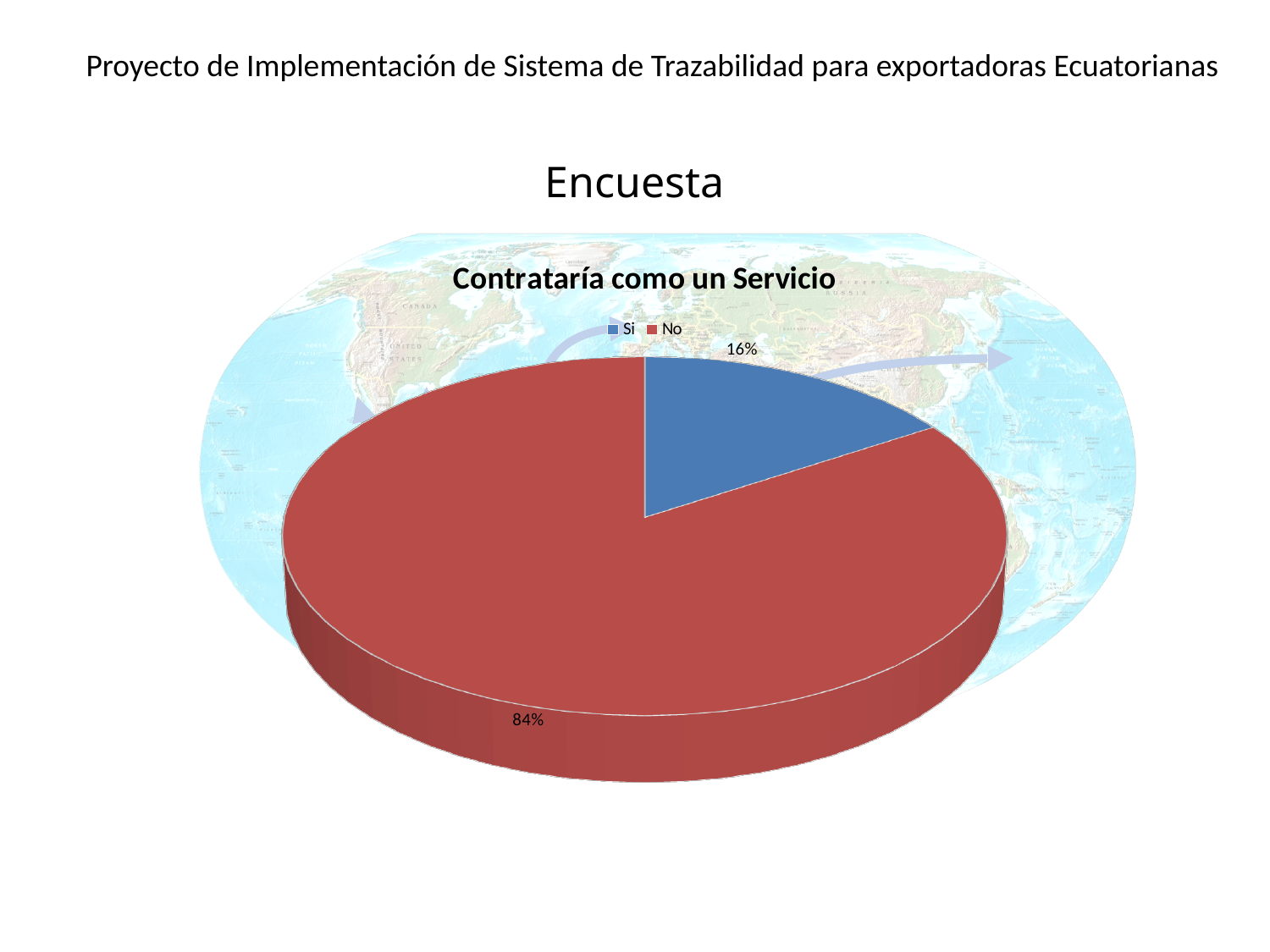
Which is larger, the 'Si' slice or the 'No' slice? No What percentage of the pie is the 'No' slice? 84% What is the difference in percentage points between the 'No' slice and the 'Si' slice? 68 Which slice is the smallest in the pie chart? Si How many entries does the legend list? 2 What percentage of the pie is the 'Si' slice? 16% What share of the pie does the 'Si' slice represent? 16% What is the title of the chart? Contrataría como un Servicio What kind of chart is shown on the slide? pie chart Which slice is the largest in the pie chart? No What colour is the 'No' slice in the pie chart? red How many slices does the pie chart have? 2